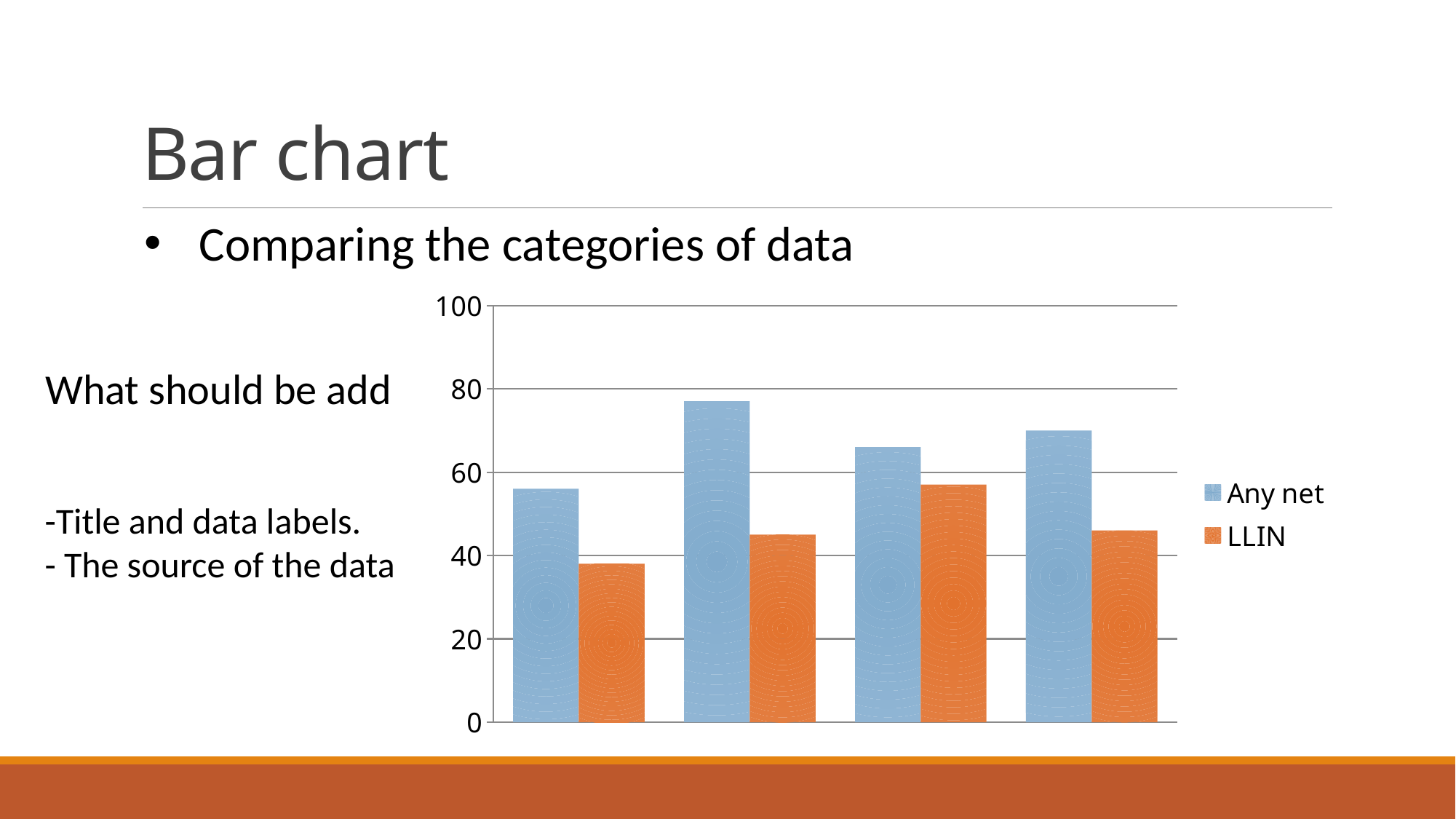
Is the LLIN value for the third group of bars from the left greater or less than 60? less In the second group of bars from the left, which series has the larger value, Any net or LLIN? Any net Which series is shown in orange according to the legend? LLIN Which series is shown in blue according to the legend? Any net How many series does the legend list? 2 How many groups of bars are plotted along the x axis? 4 What kind of chart is shown on the slide? bar chart Which group of bars from the left has the highest Any net value? the second group Is the LLIN value for the first group of bars from the left greater or less than 40? less Is the Any net value for the second group of bars from the left greater or less than 60? greater Which group of bars from the left has the lowest LLIN value? the first group